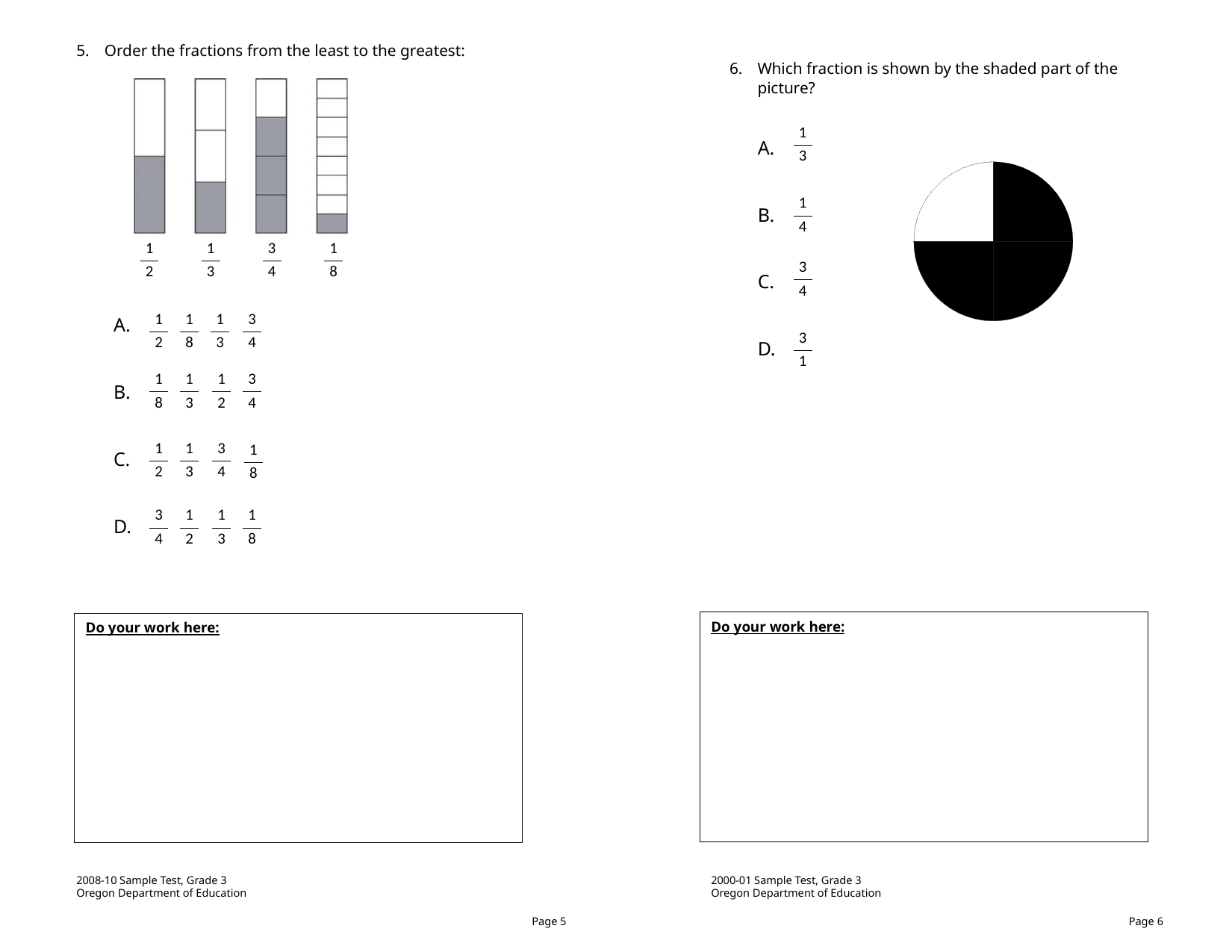
On the left slide (question 5), which fraction bar has the largest shaded part? 3/4 On the left slide (question 5), into how many equal parts is the rightmost bar divided? 8 On the right slide (question 6), what kind of chart is used to show the shaded fraction? pie chart On the right slide (question 6), what fraction of the circle is shaded black? 3/4 On the left slide (question 5), what fraction is printed under the fourth (rightmost) bar? 1/8 On the left slide (question 5), which fraction bar has the smallest shaded part? 1/8 On the right slide (question 6), into how many equal parts is the circle divided? 4 On the left slide (question 5), how many fraction bars are shown in the picture? 4 On the left slide (question 5), which bar has more shaded, the one labelled 1/8 or the one labelled 3/4? 3/4 On the left slide (question 5), which bar has more shaded, the one labelled 1/2 or the one labelled 1/3? 1/2 On the right slide (question 6), is the shaded part of the circle greater or less than one half? greater On the left slide (question 5), what fraction is printed under the first (leftmost) bar? 1/2